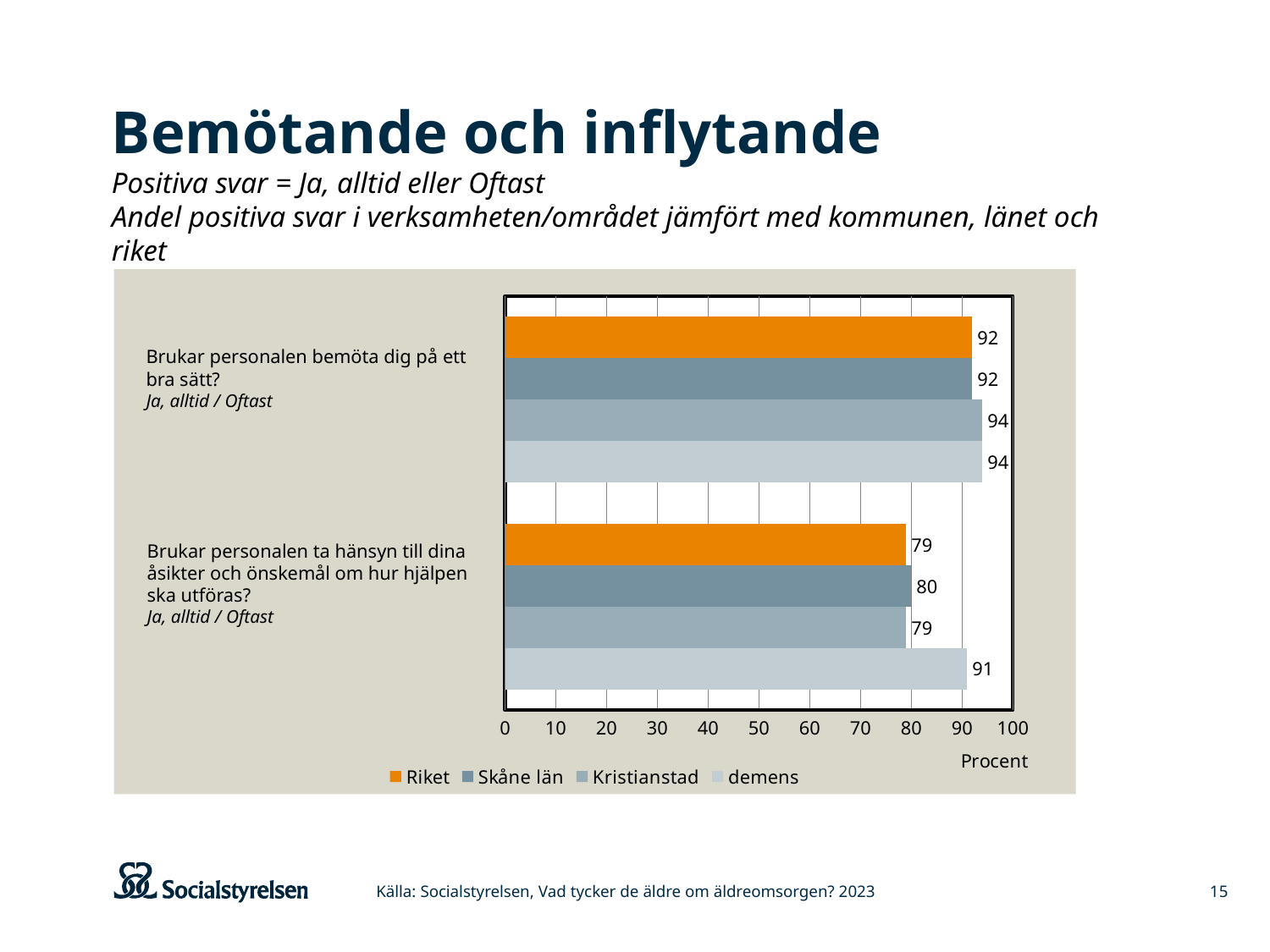
For the question "Brukar personalen bemöta dig på ett bra sätt?", which is larger: the value for Kristianstad or the value for Riket? Kristianstad Which series has the highest value for the question "Brukar personalen ta hänsyn till dina åsikter och önskemål om hur hjälpen ska utföras?"? demens What type of chart is shown on the slide? Bar chart What is the difference between the demens value and the Riket value for the question "Brukar personalen ta hänsyn till dina åsikter och önskemål om hur hjälpen ska utföras?"? 12 What is the value for Riket for the question "Brukar personalen bemöta dig på ett bra sätt?"? 92 How many series does the legend list? 4 What is the value for Kristianstad for the question "Brukar personalen bemöta dig på ett bra sätt?"? 94 What unit is shown on the x axis of the chart? Procent How many questions (categories) are plotted on the chart? 2 What is the value for demens for the question "Brukar personalen ta hänsyn till dina åsikter och önskemål om hur hjälpen ska utföras?"? 91 Is the value for Riket for the question "Brukar personalen ta hänsyn till dina åsikter och önskemål om hur hjälpen ska utföras?" greater or less than 80? less What is the value for Skåne län for the question "Brukar personalen ta hänsyn till dina åsikter och önskemål om hur hjälpen ska utföras?"? 80